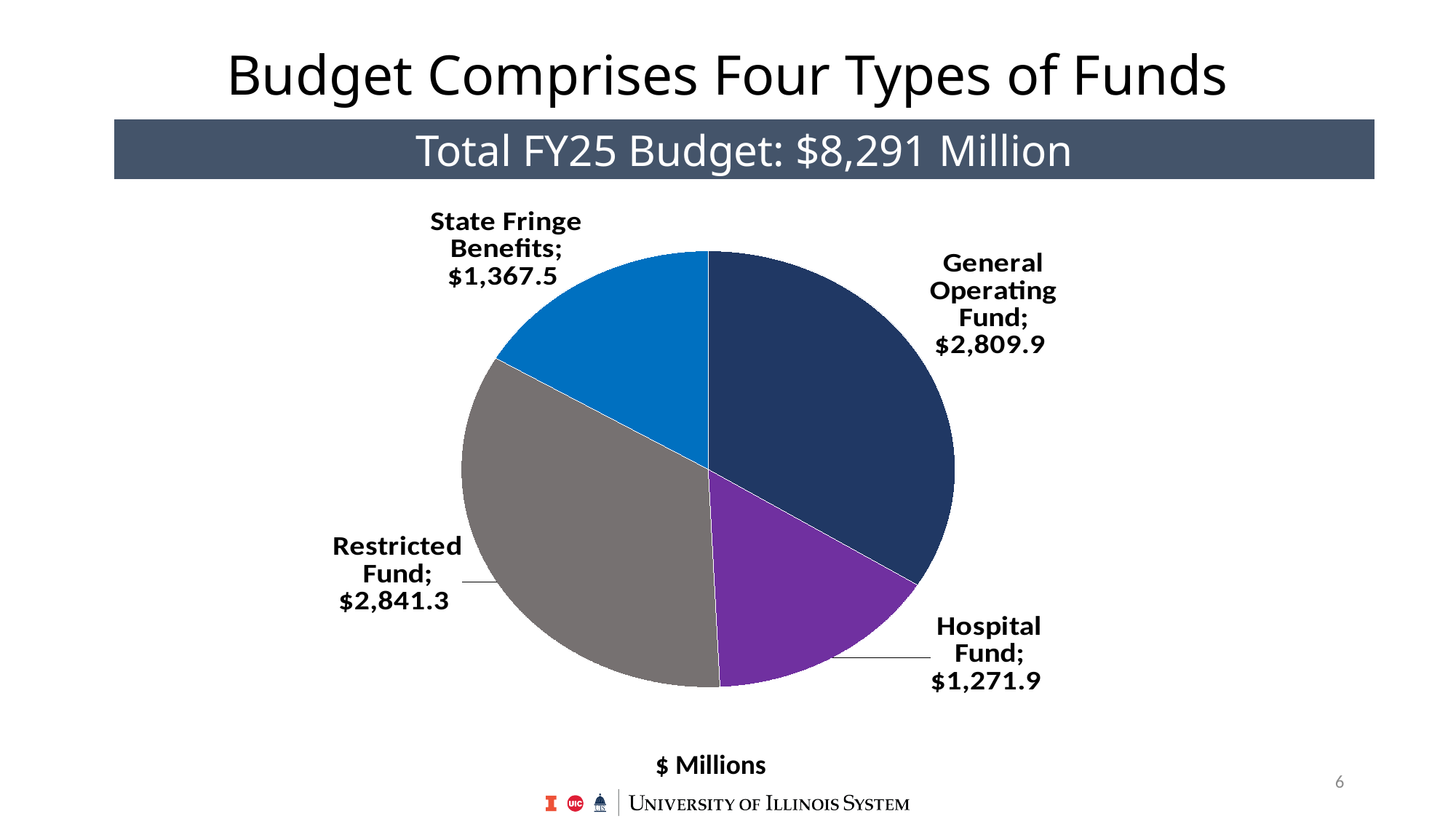
What is the difference between the Restricted Fund and the General Operating Fund? $31.4 What type of chart is shown on the slide? Pie chart What unit is stated below the pie chart? $ Millions What is the value for State Fringe Benefits? $1,367.5 What is the difference between State Fringe Benefits and the Hospital Fund? $95.6 Which fund has the largest value in the pie chart? Restricted Fund Which is larger, State Fringe Benefits or the Hospital Fund? State Fringe Benefits Which fund has the smallest value in the pie chart? Hospital Fund What is the value for the Hospital Fund? $1,271.9 How many fund types (slices) does the pie chart show? 4 What is the value for the Restricted Fund? $2,841.3 What is the value for the General Operating Fund? $2,809.9